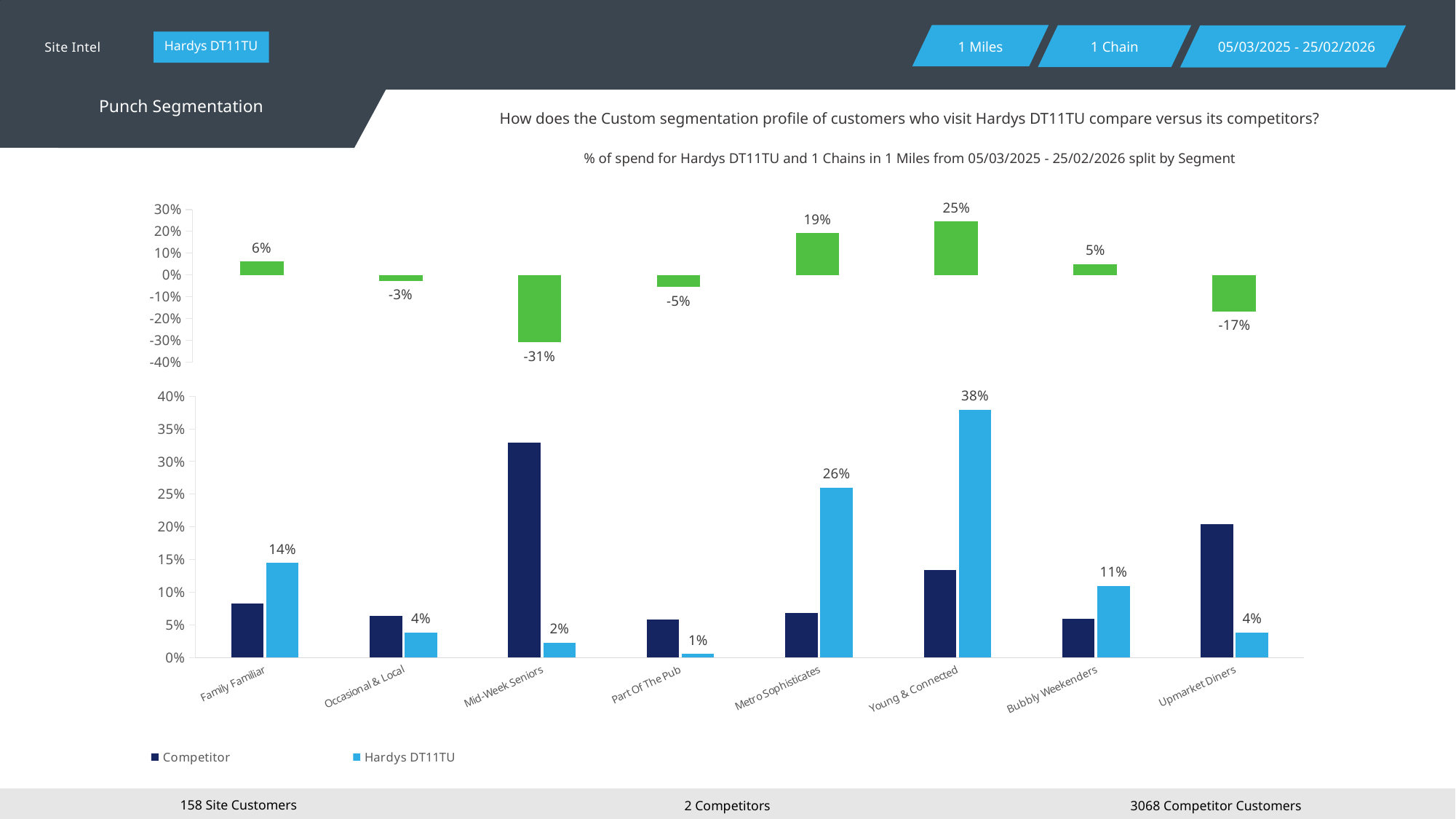
In the bottom chart, what is the difference between the Hardys DT11TU values for Young & Connected and Family Familiar? 24% In the bottom chart, is the Competitor value for Mid-Week Seniors greater or less than 30%? greater In the top chart, what is the value for Upmarket Diners? -17% In the bottom chart, is the Competitor value for Upmarket Diners greater or less than 15%? greater In the bottom chart, for Mid-Week Seniors, which is larger: the Competitor value or the Hardys DT11TU value? Competitor How many series does the legend of the bottom chart list? 2 In the top chart, which segment has the highest value? Young & Connected In the top chart, what is the value for Young & Connected? 25% In the bottom chart, which segment has the highest Hardys DT11TU value? Young & Connected In the top chart, which segment has the lowest value? Mid-Week Seniors How many segments are shown on the x axis of the bottom chart? 8 In the bottom chart, what is the Hardys DT11TU value for Metro Sophisticates? 26%